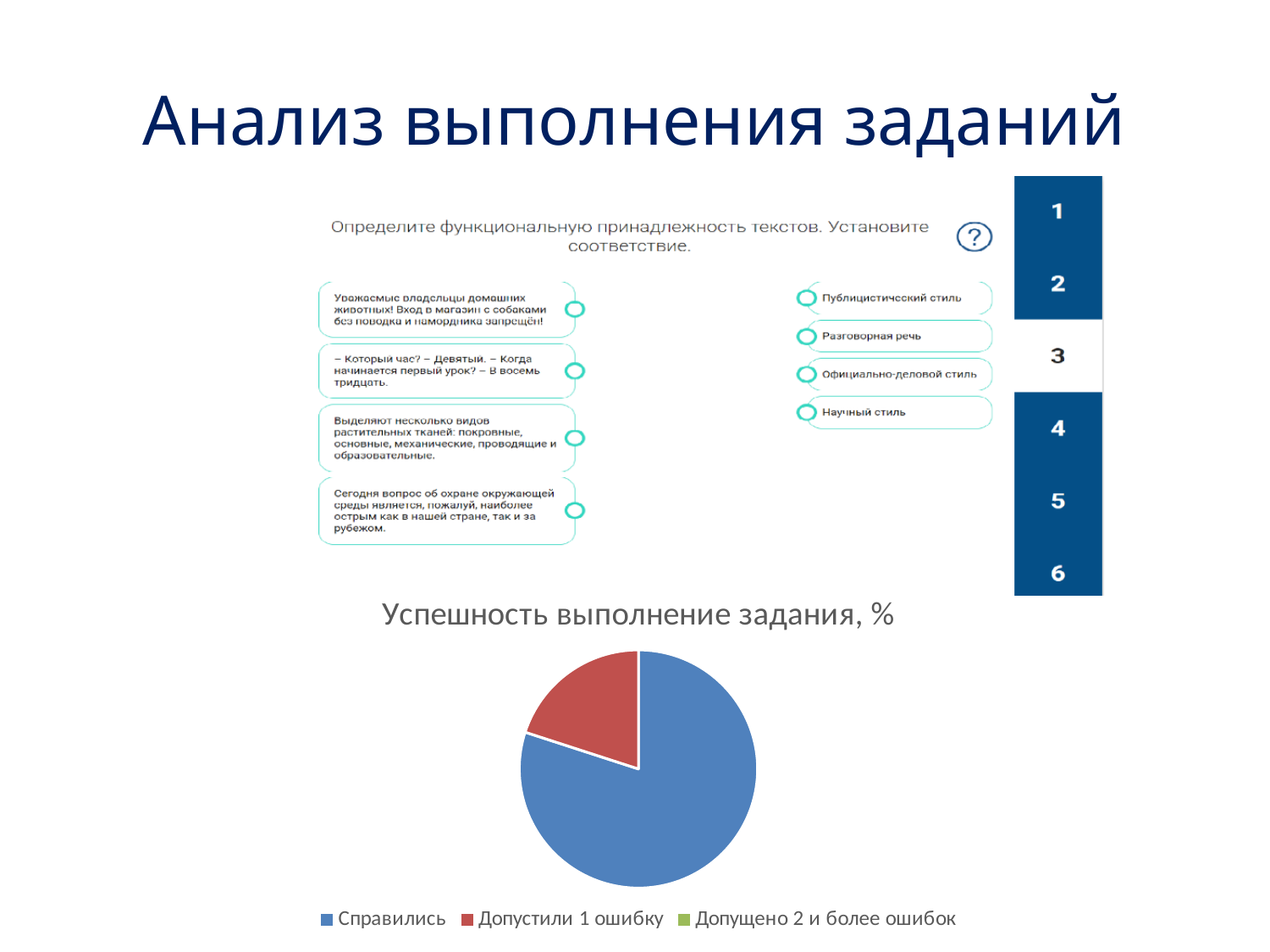
How many slices are visible in the pie chart? 2 What is the title of the pie chart on the slide? Успешность выполнение задания, % Which legend category of the pie chart has no visible slice? Допущено 2 и более ошибок What kind of chart is shown under the heading "Успешность выполнение задания, %"? pie chart How many categories does the legend of the pie chart list? 3 Which colour represents "Справились" in the pie chart? blue Which category has the largest slice in the pie chart? Справились Which category is shown in red in the pie chart? Допустили 1 ошибку Which slice is larger in the pie chart: "Справились" or "Допустили 1 ошибку"? Справились